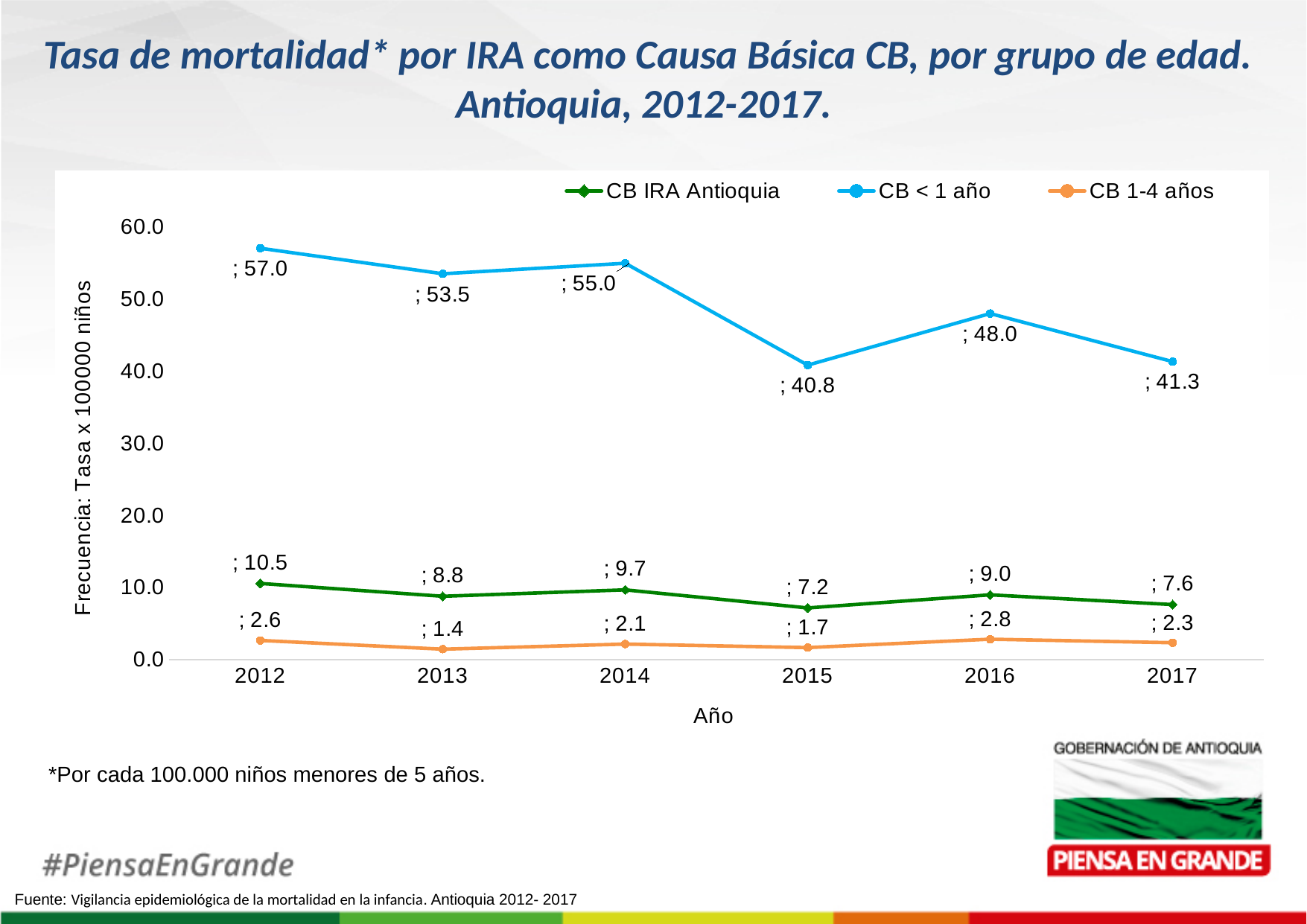
What is the difference between the CB < 1 año values for 2014 and 2015? 14.2 What is the value for CB IRA Antioquia in 2015? 7.2 In which year is the CB < 1 año series highest? 2012 Is the value for CB < 1 año in 2016 greater or less than 40.0? greater How many years are shown on the x axis? 6 What kind of chart is shown on the slide? line chart Which is larger, the CB IRA Antioquia value for 2012 or for 2017? 2012 How many series does the legend list? 3 What is the label of the y axis? Frecuencia: Tasa x 100000 niños What is the value for CB 1-4 años in 2016? 2.8 In which year is the CB 1-4 años series lowest? 2013 What is the value for CB < 1 año in 2012? 57.0